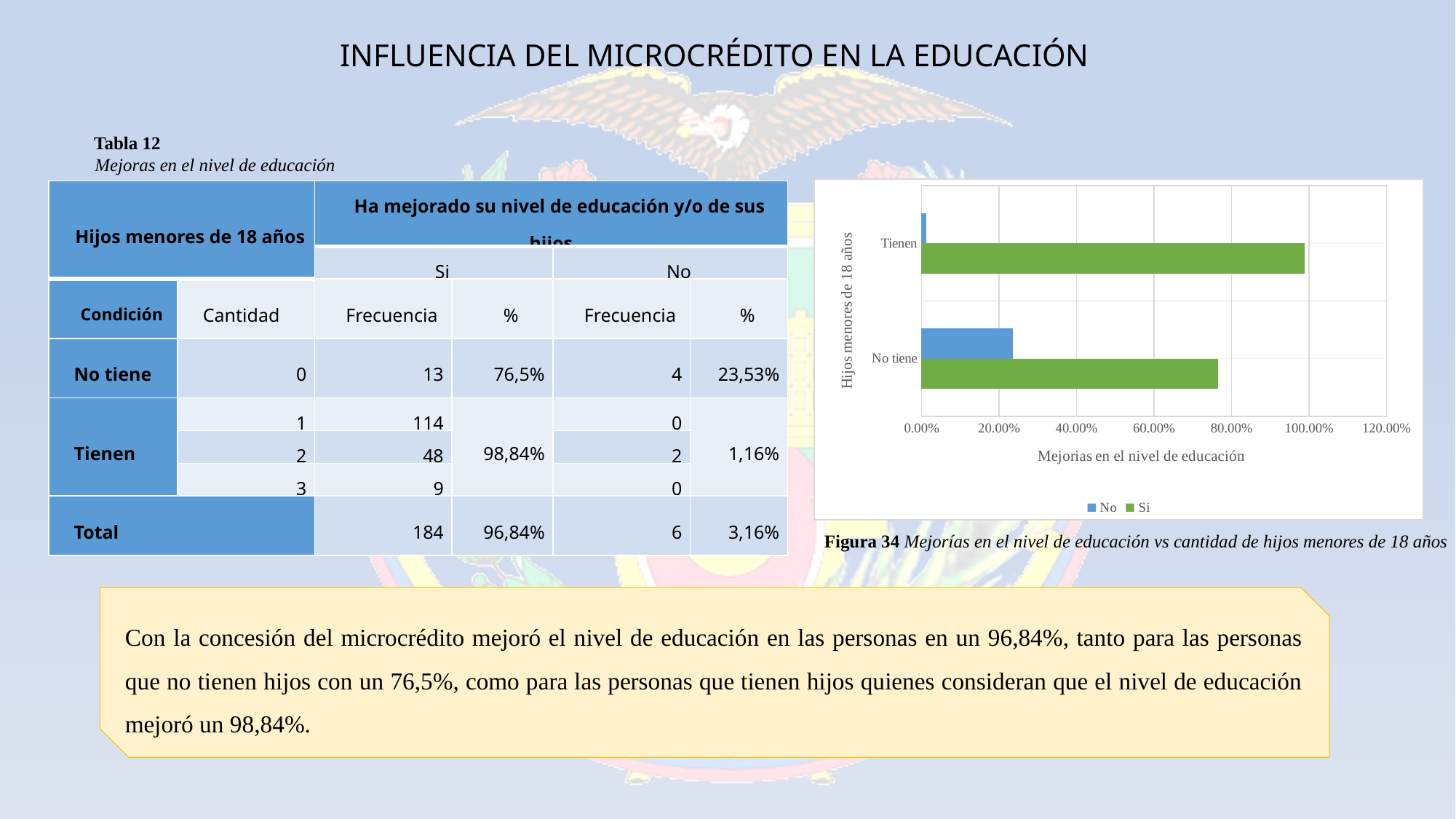
What kind of chart is shown in Figura 34? bar chart Is the value of the No series for Tienen greater or less than 20.00%? less Which category has the higher value for the Si series, Tienen or No tiene? Tienen Is the value of the No series for No tiene greater or less than 40.00%? less Is the value of the Si series for No tiene greater or less than 80.00%? less For the No tiene category, which series has the larger bar, No or Si? Si Which category has the lower value for the No series? Tienen How many series does the legend of the chart list? 2 Which series is shown in green in the chart? Si How many categories are shown on the vertical axis of the chart? 2 What is the title of the horizontal axis of the chart? Mejorias en el nivel de educación